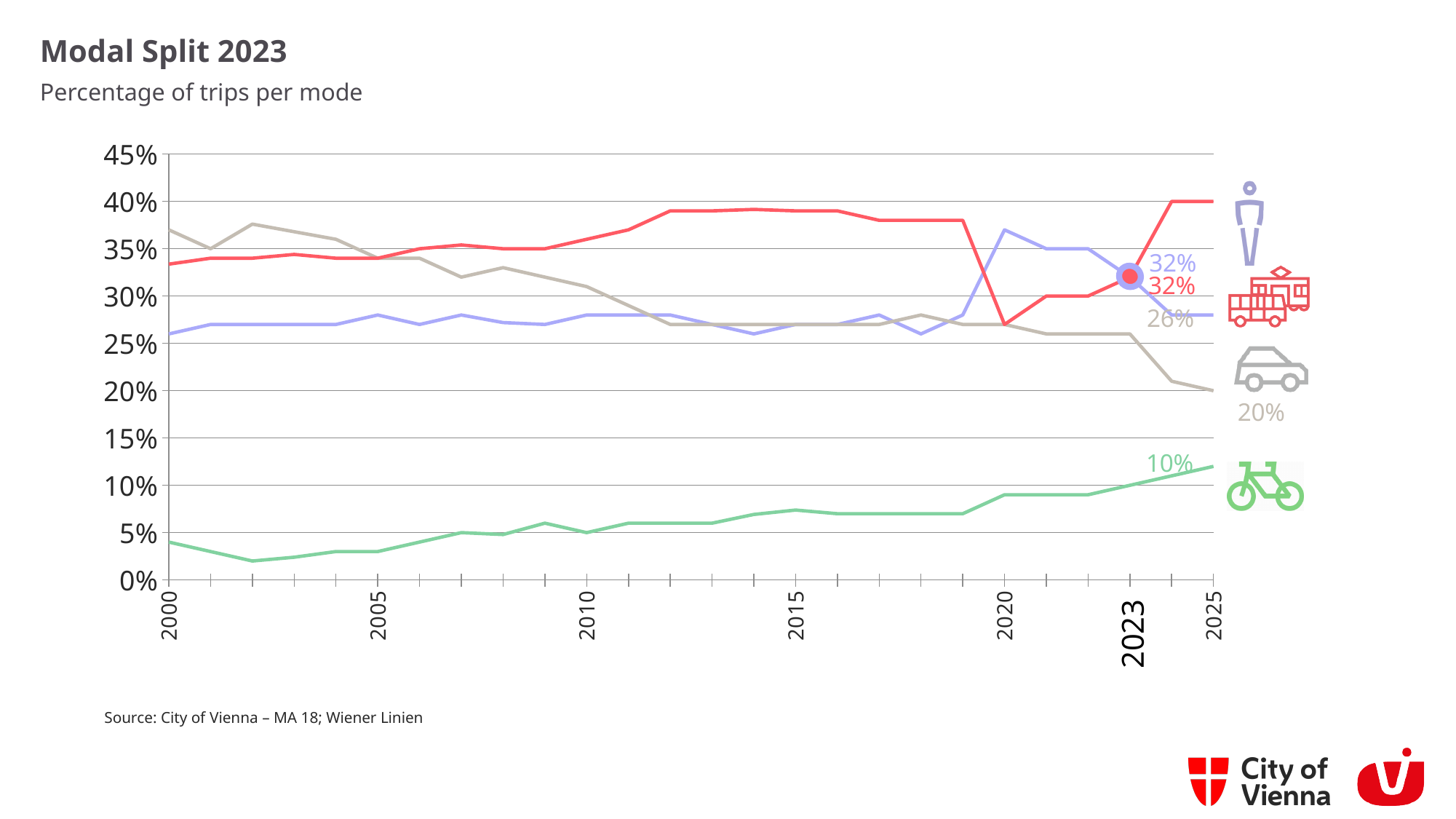
How many lines (modes) are plotted in the chart? 4 What is the difference between the grey line (car) and the green line (bicycle) labelled values at 2023? 16 percentage points What value is labelled for the blue line (walking) at 2023? 32% Does the green line (bicycle) generally rise or fall from 2000 to 2025? rise What kind of chart is shown on the slide? line chart Is the value of the green line (bicycle) in 2000 greater or less than 10%? less What value is labelled for the green line (bicycle) at 2023? 10% What value is labelled for the red line (public transport) at 2023? 32% What is the title of the chart on the slide? Modal Split 2023 Which mode has the lowest labelled share in 2023? bicycle (green line), 10% What value is labelled for the grey line (car) at 2023? 26% At 2023, which is larger: the labelled value of the red line (public transport) or the grey line (car)? red line (public transport), 32%